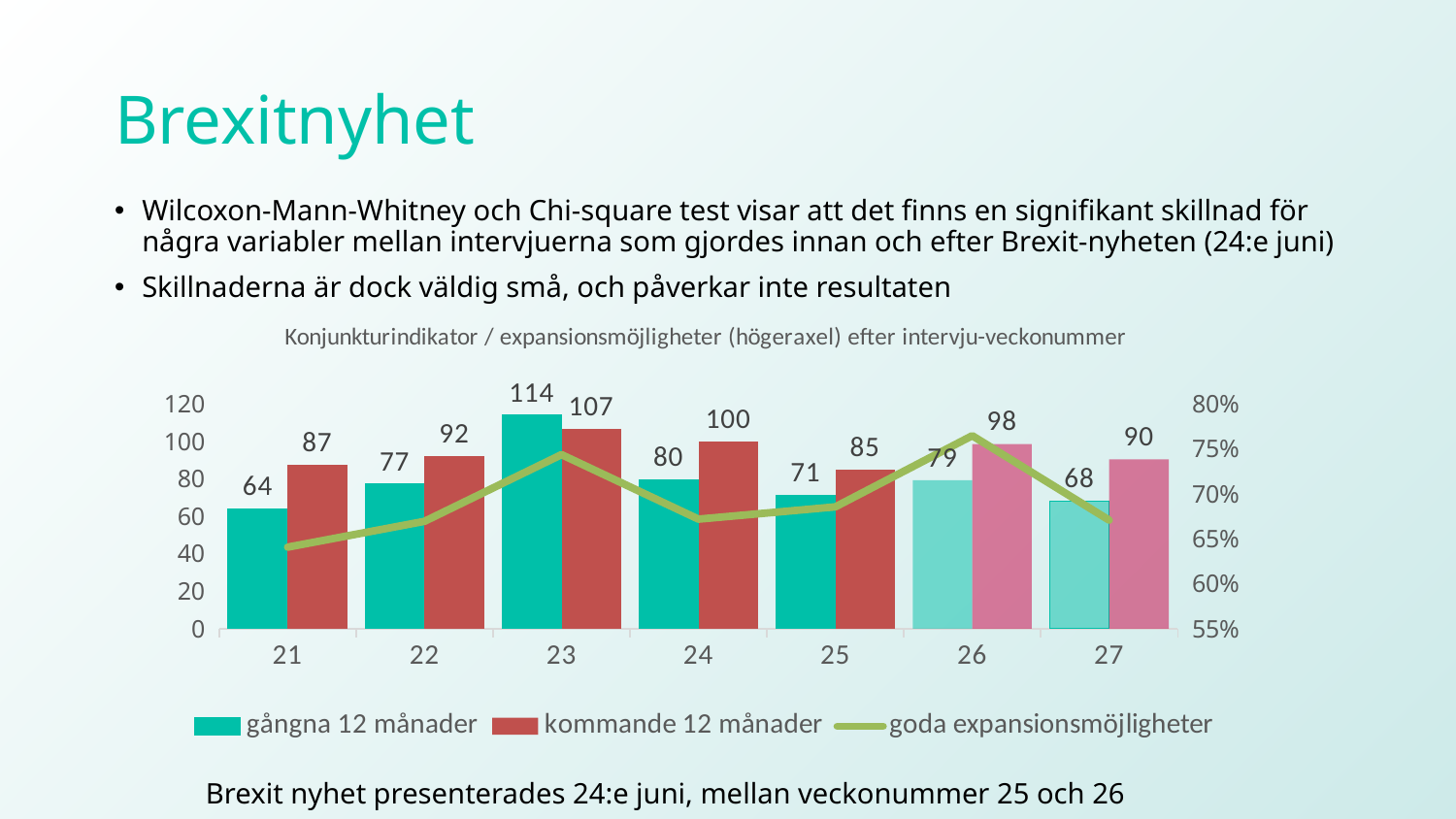
How many series does the legend list? 3 Is the value of 'goda expansionsmöjligheter' in week 23 greater or less than 70%? greater Which week has the highest value for 'kommande 12 månader'? 23 What is the difference between 'kommande 12 månader' and 'gångna 12 månader' in week 21? 23 Is the value of 'goda expansionsmöjligheter' in week 24 greater or less than 70%? less What is the value for 'kommande 12 månader' in week 24? 100 Which series is plotted as a line rather than bars? goda expansionsmöjligheter What is the value for 'gångna 12 månader' in week 23? 114 Which week has the lowest value for 'gångna 12 månader'? 21 How many weeks are shown on the x axis? 7 Which is larger in week 26: 'gångna 12 månader' or 'kommande 12 månader'? kommande 12 månader What is the value for 'gångna 12 månader' in week 27? 68